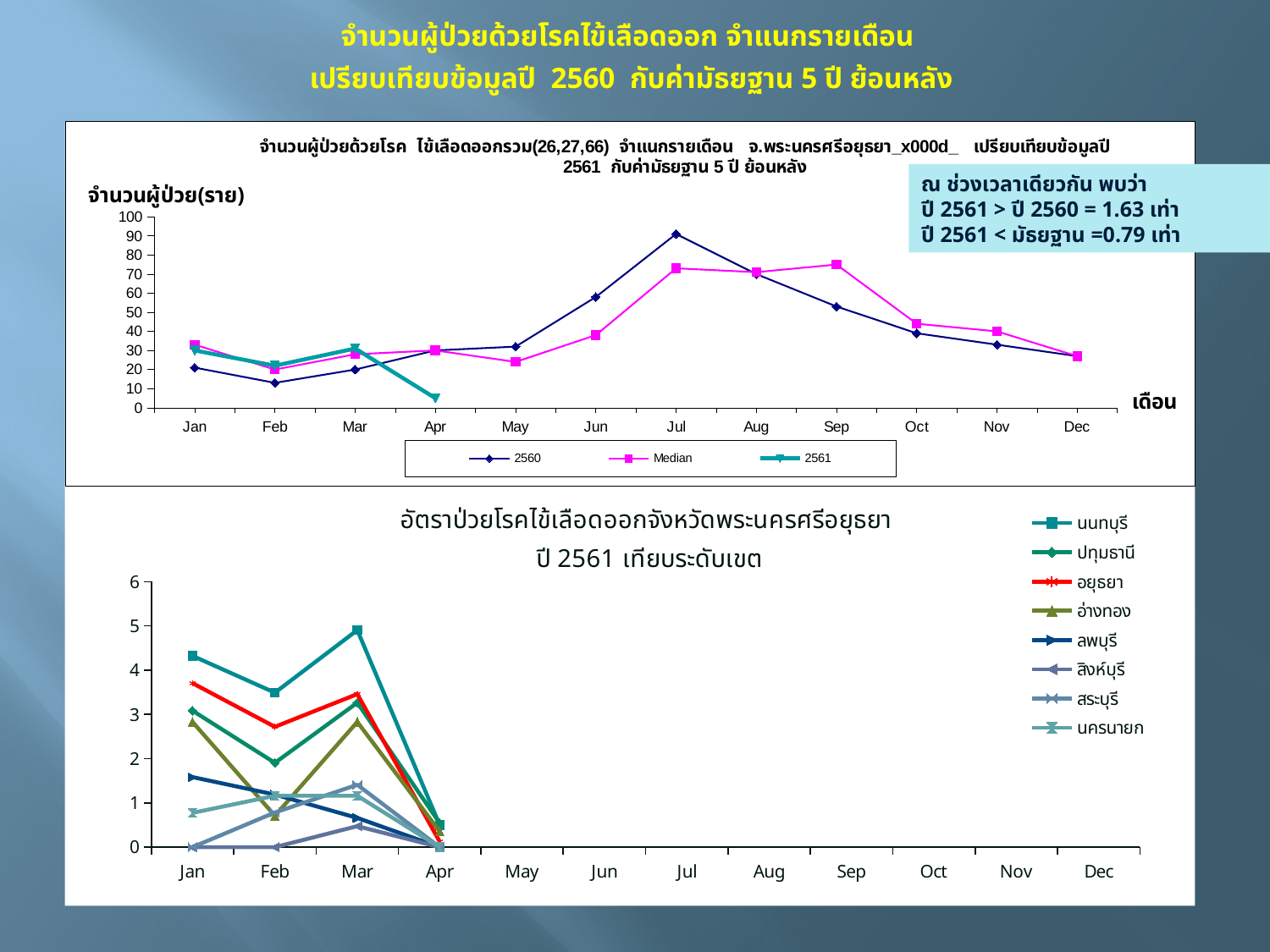
In the bottom chart, which is larger in Jan: นนทบุรี or อยุธยา? นนทบุรี How many series does the legend of the bottom chart list? 8 In the top chart, does the 2560 series rise or fall from Sep to Dec? fall In the top chart, is the value of the 2561 series in Apr greater or less than 10? less In the top chart, is the value of the 2560 series in Jul greater or less than 80? greater In the bottom chart, which province has the highest value in Mar? นนทบุรี In the top chart, in which month is the 2560 series at its lowest? Feb In the bottom chart, is the value for นนทบุรี in Mar greater or less than 4? greater How many series does the legend of the top chart list? 3 In the top chart, in which month does the 2560 series reach its highest value? Jul What kind of chart is the top chart on the slide? line chart In the top chart, how many months have a plotted point for the 2561 series? 4